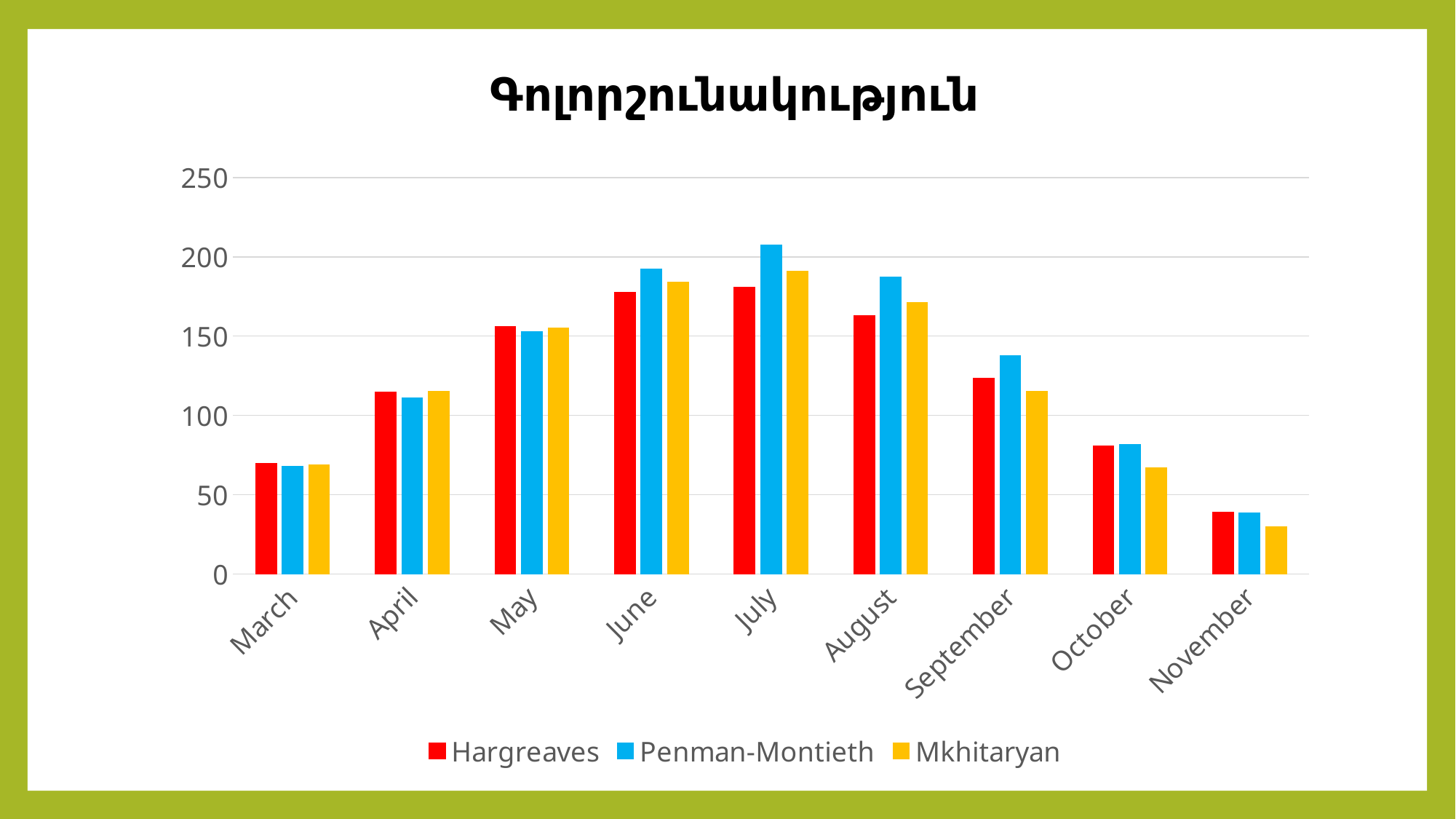
Is the Hargreaves value for September greater or less than 100? greater In which month is the Mkhitaryan value lowest? November In July, which is larger: the Hargreaves value or the Penman-Montieth value? Penman-Montieth Is the Penman-Montieth value for July greater or less than 200? greater Is the Mkhitaryan value for November greater or less than 50? less Do the Hargreaves values rise or fall from July to November? fall How many series does the legend list? 3 What kind of chart is shown on the slide? bar chart Which series is shown in red? Hargreaves How many months are shown on the x axis? 9 In which month is the Penman-Montieth value highest? July